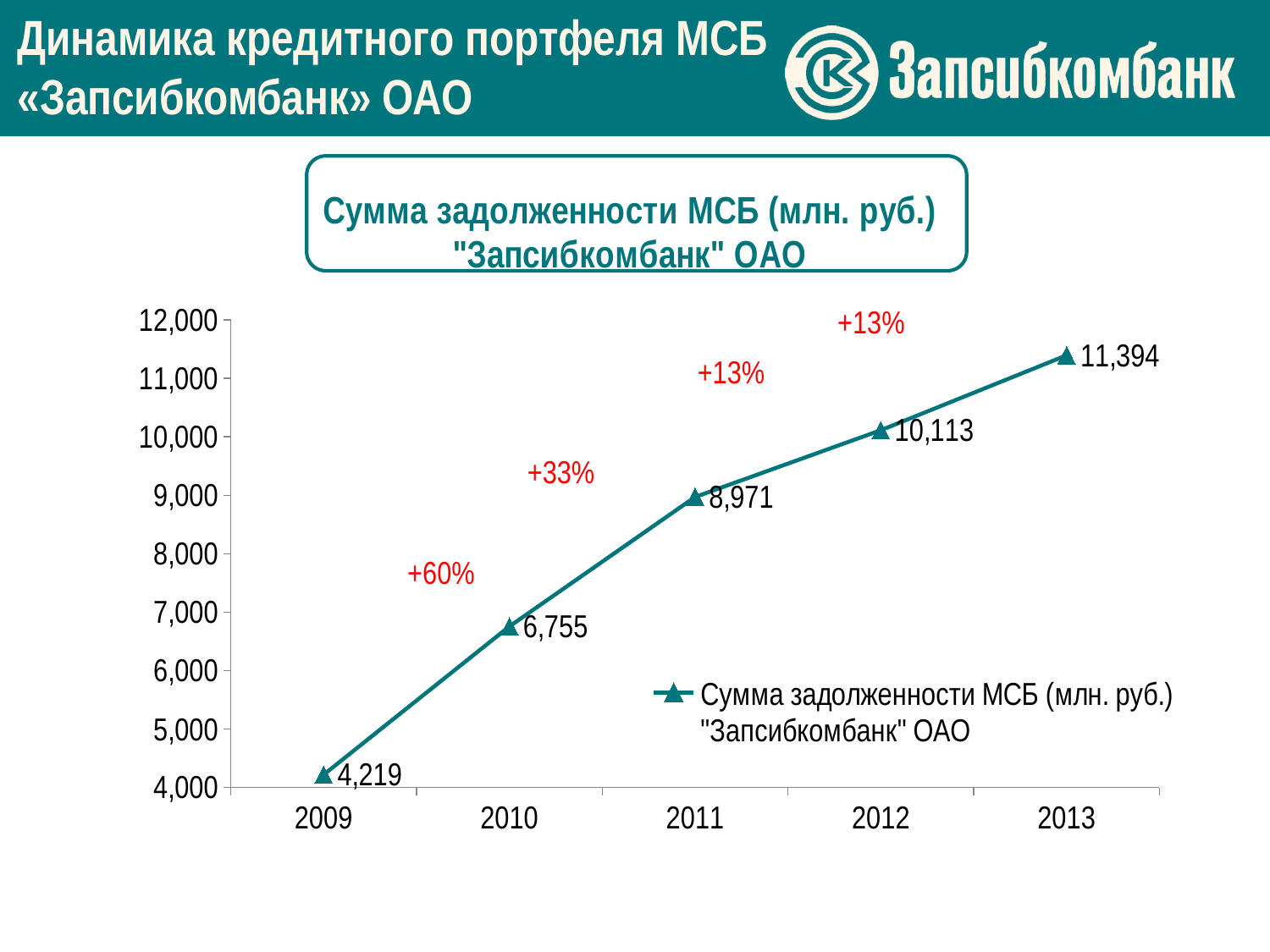
How many years are plotted on the chart? 5 What percentage growth is annotated between 2009 and 2010? +60% What is the value for 2009? 4,219 What is the value for 2013? 11,394 What is the value for 2011? 8,971 Which year has the highest value? 2013 What is the difference between the values for 2013 and 2012? 1,281 What is the difference between the values for 2010 and 2009? 2,536 Which year has the lowest value? 2009 Do the values rise or fall from 2009 to 2013? rise What kind of chart is shown? line chart Which is larger, the value for 2011 or the value for 2010? 2011